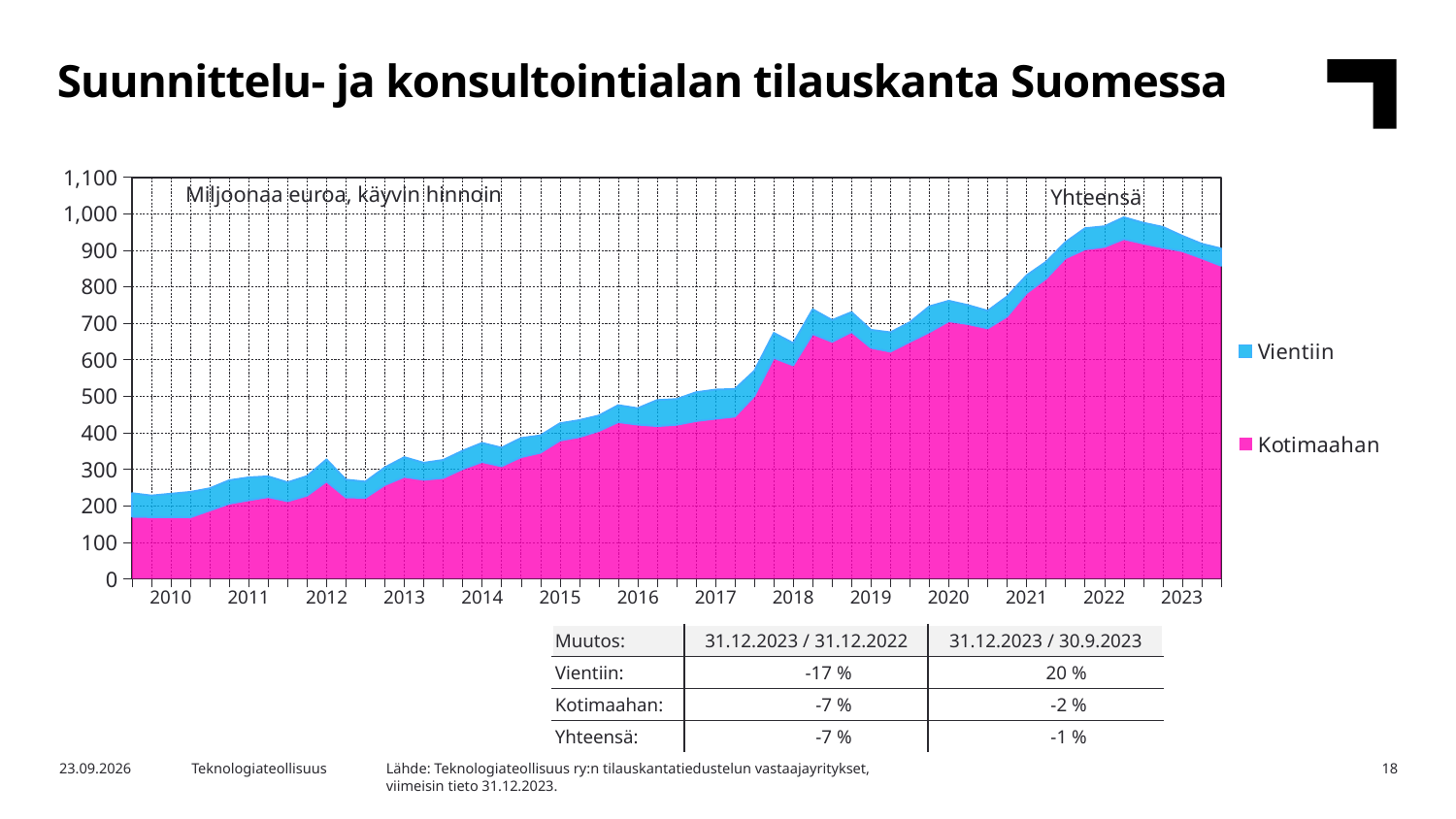
What unit label is shown inside the chart area at the top left? Miljoonaa euroa, käyvin hinnoin Is the total (Yhteensä) value at the start of 2010 greater or less than 300? less Does the total order backlog generally rise or fall from 2010 to 2022? rise How many series does the chart legend list? 2 Which series, Vientiin or Kotimaahan, makes up the larger part of the stacked total throughout the chart? Kotimaahan Is the Kotimaahan value at the end of 2023 greater or less than 800? greater Is the Kotimaahan value at the start of 2010 greater or less than 200? less What are the two series named in the chart legend? Vientiin and Kotimaahan What type of chart is shown on the slide? Stacked area chart In which year does the total (Yhteensä) reach its highest point on the chart? 2022 According to the table below the chart, what is the change in Vientiin for 31.12.2023 / 31.12.2022? -17 %